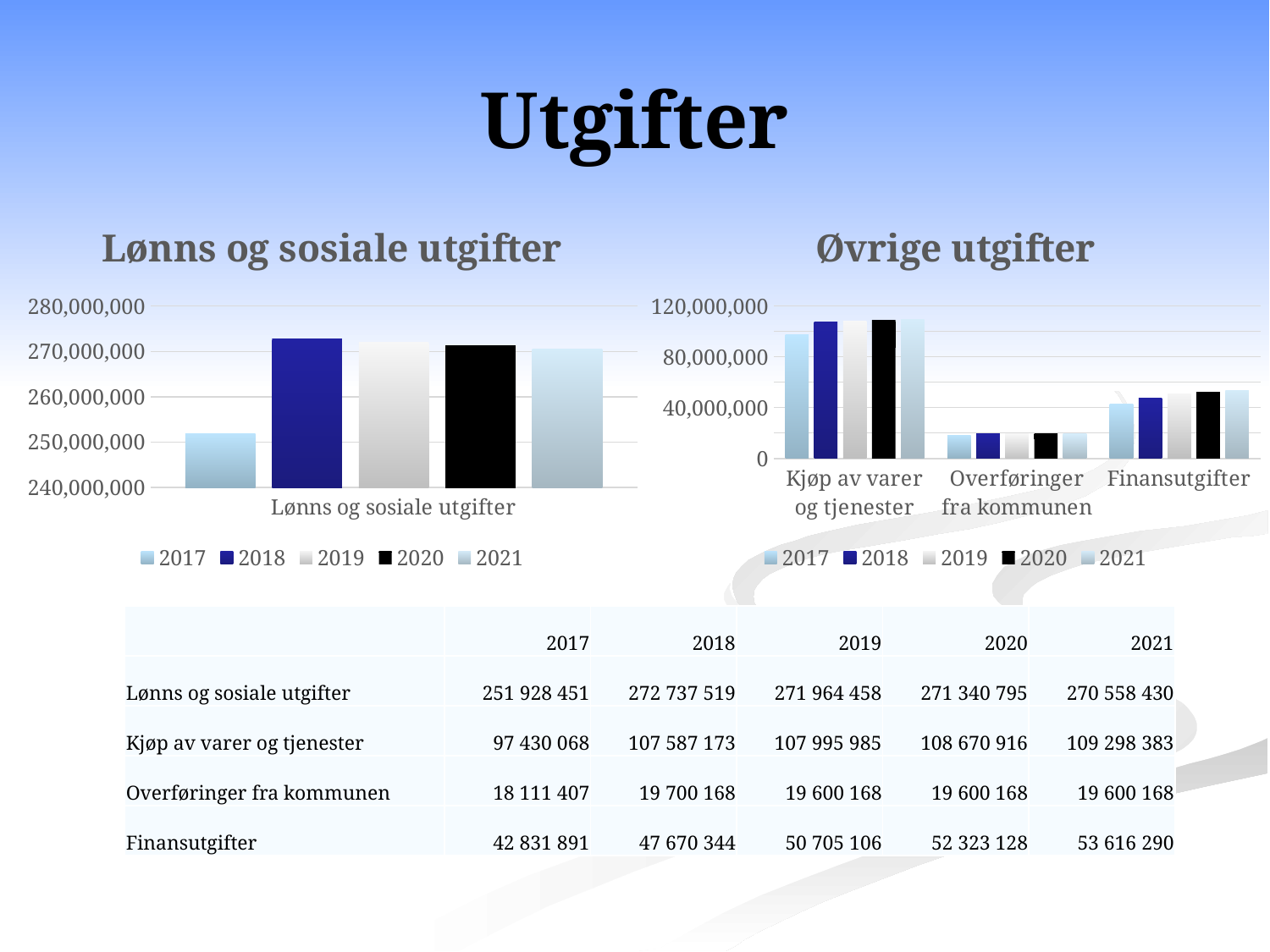
Using the table values, what is the difference between Finansutgifter in 2021 and in 2017? 10 784 399 How many categories are shown on the x axis of the 'Øvrige utgifter' chart? 3 In the 'Øvrige utgifter' chart, do the values for Finansutgifter rise or fall from 2017 to 2021? rise What kind of chart is the 'Lønns og sosiale utgifter' chart? bar chart How many series does the legend of the 'Øvrige utgifter' chart list? 5 In the 'Lønns og sosiale utgifter' chart, is the value for 2017 greater or less than 260,000,000? less In the 'Øvrige utgifter' chart, which category has the lowest values? Overføringer fra kommunen What is the value for Lønns og sosiale utgifter in 2021, as shown in the table? 270 558 430 In the 'Øvrige utgifter' chart, which category has the highest values? Kjøp av varer og tjenester In the 'Øvrige utgifter' chart, is the 2017 value for Finansutgifter greater or less than 40,000,000? greater In the 'Lønns og sosiale utgifter' chart, which year has the lowest value? 2017 In the 'Lønns og sosiale utgifter' chart, which year has the highest value? 2018